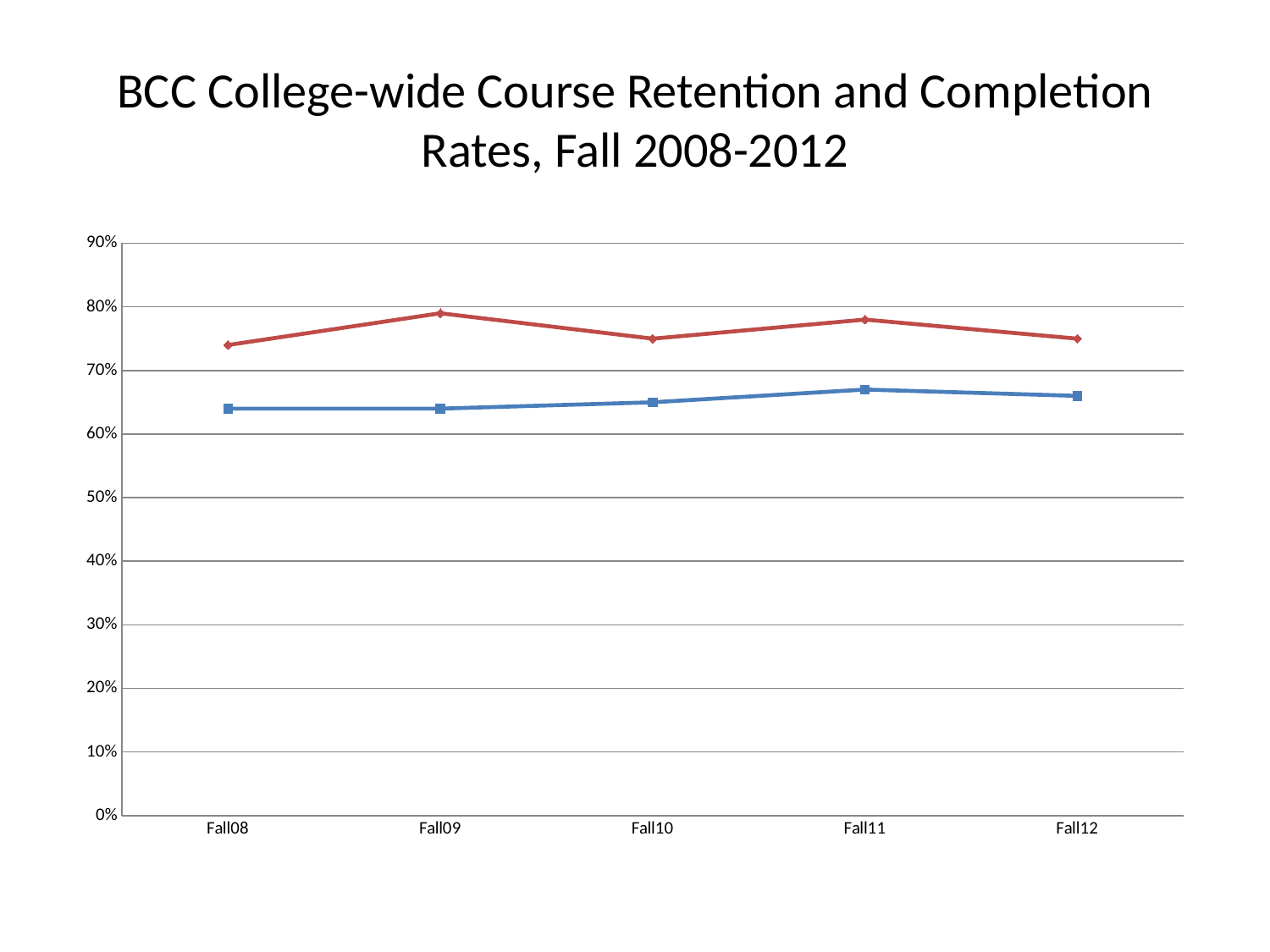
Does the blue line rise or fall from Fall09 to Fall11? rise What kind of chart is shown on the slide? line chart How many terms are plotted along the x axis? 5 Is the value of the blue line at Fall08 greater or less than 60%? greater How many lines are plotted on the chart? 2 What is the first term shown on the x axis? Fall08 What is the title of the chart? BCC College-wide Course Retention and Completion Rates, Fall 2008-2012 Is the value of the blue line at Fall11 greater or less than 70%? less Is the value of the red line at Fall12 greater or less than 70%? greater At Fall10, which line has the higher value, the red line or the blue line? the red line